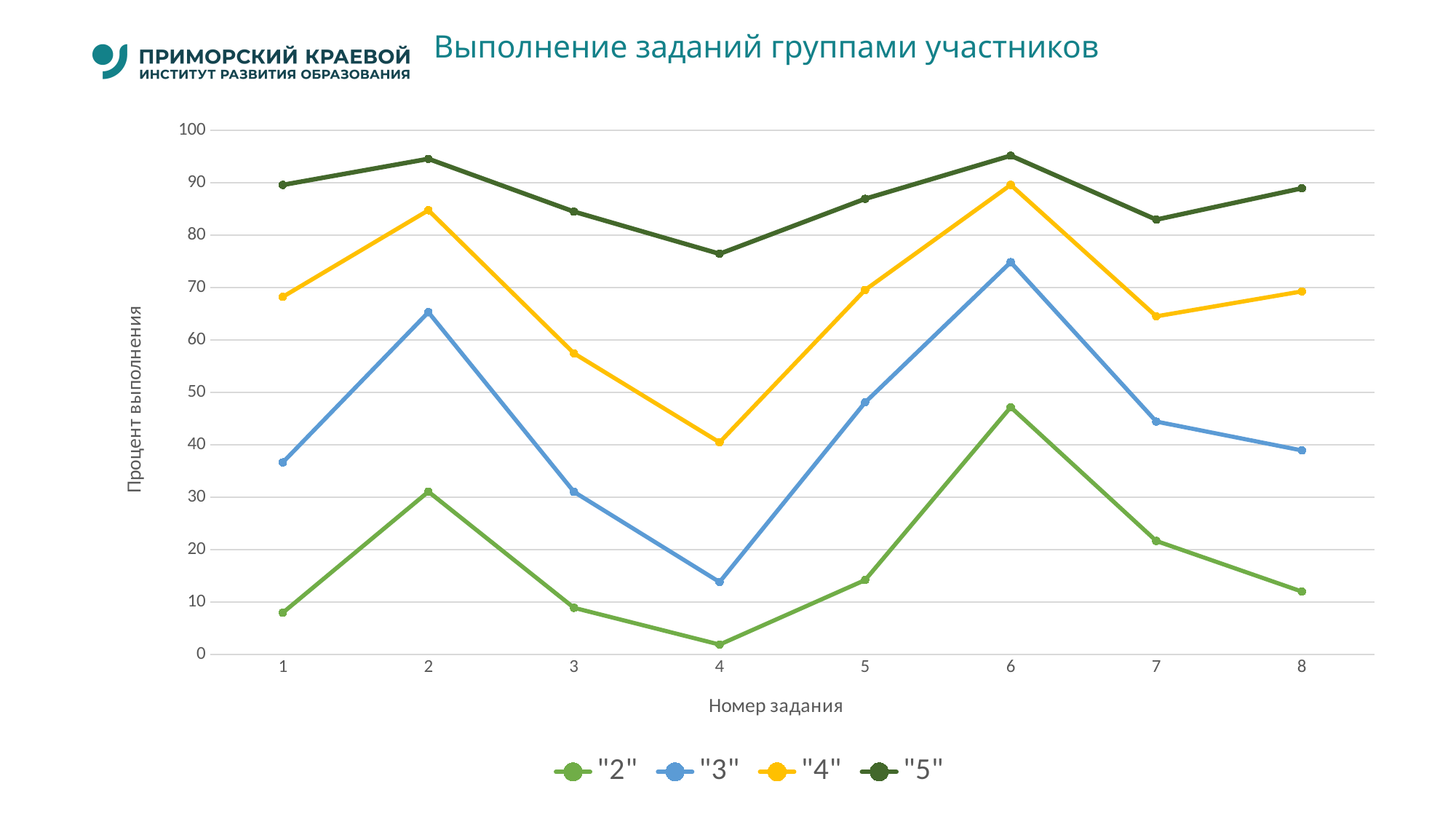
For which task number does the "2" series reach its lowest value? 4 What is the title of the chart? Выполнение заданий группами участников Does the "2" series rise or fall from task 6 to task 8? fall For the "3" series, which is larger: the value at task 2 or the value at task 8? task 2 Is the value for the "4" series at task 4 greater or less than 50? less For which task number does the "4" series reach its highest value? 6 How many task numbers are plotted along the x axis? 8 How many series does the legend list? 4 What kind of chart is shown on the slide? line chart Is the value for the "3" series at task 6 greater or less than 70? greater For which task number does the "5" series reach its lowest value? 4 For which task number does the "2" series reach its highest value? 6